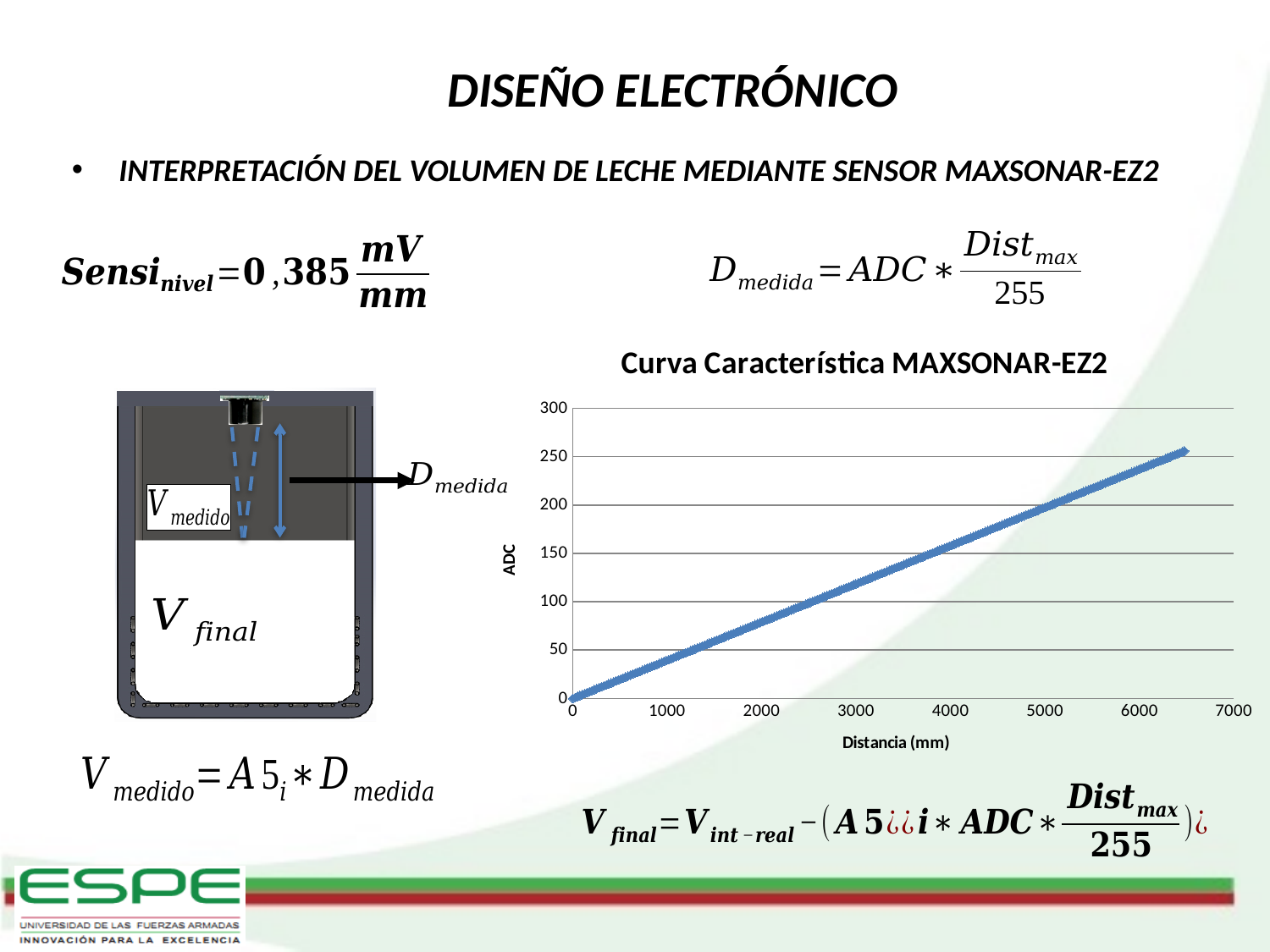
Is the ADC value at a distance of 3000 mm greater or less than 100? greater Which has the larger ADC value on the chart: a distance of 2000 mm or a distance of 5000 mm? 5000 mm What is the label of the horizontal axis of the chart? Distancia (mm) Is the highest ADC value plotted on the chart greater or less than 300? less What is the title of the chart on the slide? Curva Característica MAXSONAR-EZ2 Do the ADC values rise or fall as the distance increases along the x axis? rise Is the ADC value at a distance of 2000 mm greater or less than 50? greater What kind of chart is shown under the title "Curva Característica MAXSONAR-EZ2"? line chart